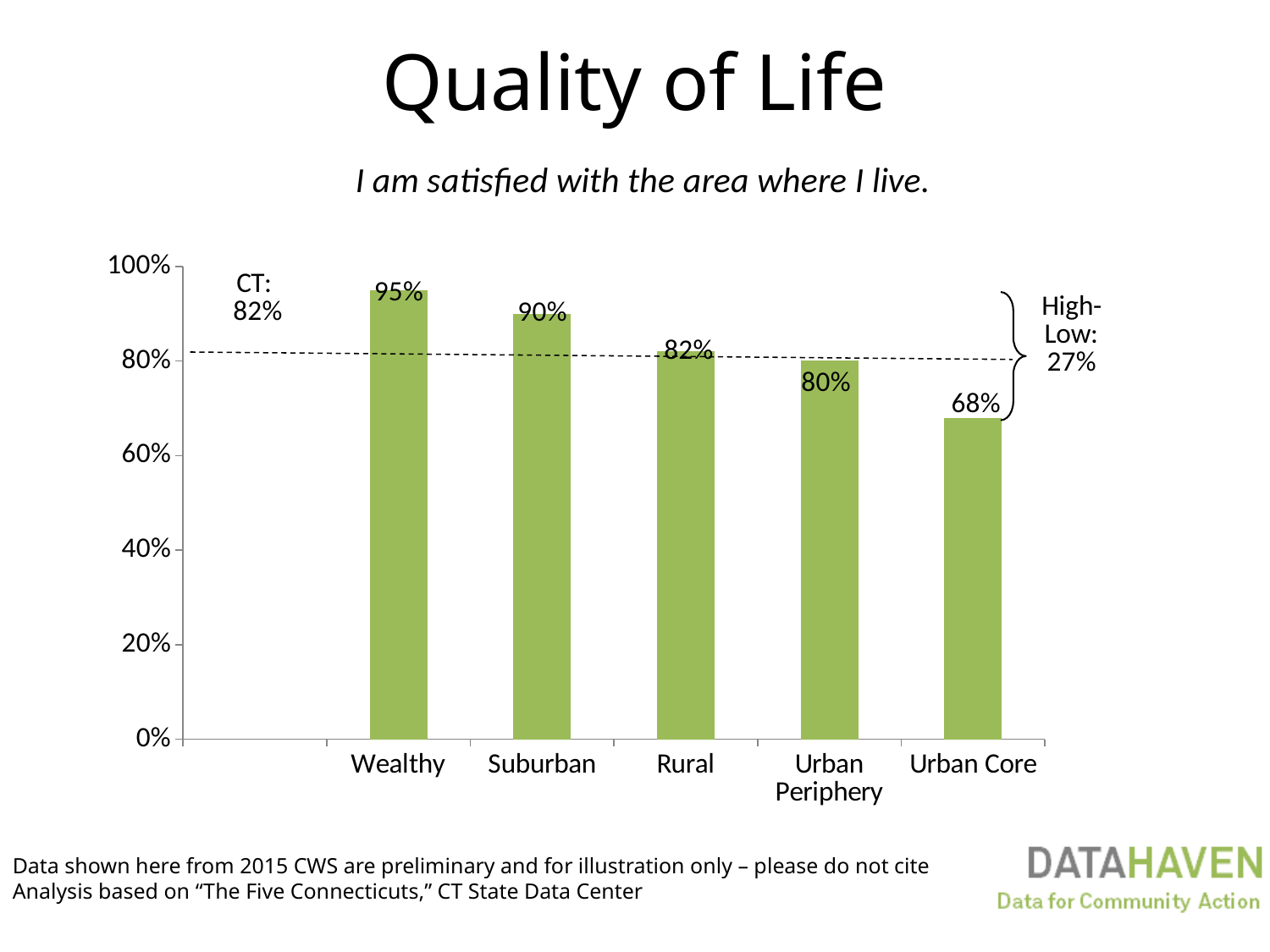
What is the value shown for Urban Periphery? 80% What is the CT statewide value indicated by the dashed line? 82% Which category has the lowest satisfaction value? Urban Core How many categories are shown on the x axis? 5 What percentage of Wealthy respondents are satisfied with the area where they live? 95% Which is larger, the value for Rural or the value for Urban Periphery? Rural Which category has the highest satisfaction value? Wealthy What is the value shown for Urban Core? 68% What is the difference between the Suburban and Rural values? 8% What kind of chart is shown on the slide? Bar chart What is the difference between the Wealthy and Urban Core values? 27% What is the value shown for Suburban? 90%